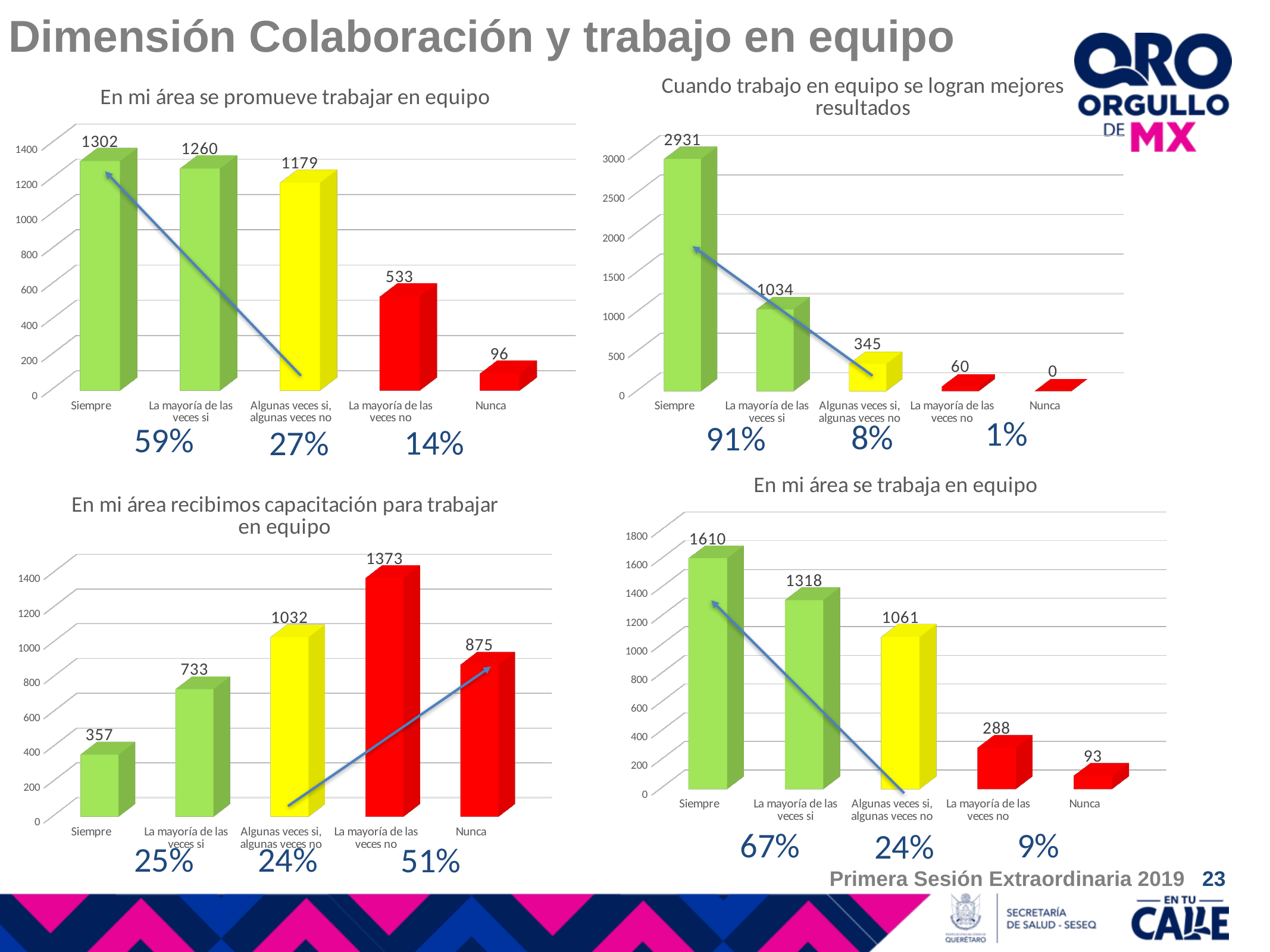
In the chart 'En mi área se trabaja en equipo', what is the value for 'La mayoría de las veces no'? 288 In the chart 'Cuando trabajo en equipo se logran mejores resultados', what is the value for 'Nunca'? 0 In the chart 'En mi área recibimos capacitación para trabajar en equipo', what is the value for 'Siempre'? 357 In the chart 'En mi área recibimos capacitación para trabajar en equipo', which is larger: 'Algunas veces si, algunas veces no' or 'Nunca'? Algunas veces si, algunas veces no How many categories are shown in the chart 'En mi área se trabaja en equipo'? 5 In the chart 'En mi área se trabaja en equipo', what is the difference between 'Siempre' and 'La mayoría de las veces si'? 292 In the chart 'En mi área se promueve trabajar en equipo', what is the value for 'Siempre'? 1302 In the chart 'Cuando trabajo en equipo se logran mejores resultados', what is the value for 'La mayoría de las veces si'? 1034 What kind of chart is 'En mi área se promueve trabajar en equipo'? Bar chart In the chart 'En mi área se promueve trabajar en equipo', which category has the lowest value? Nunca In the chart 'En mi área recibimos capacitación para trabajar en equipo', which category has the highest value? La mayoría de las veces no In the chart 'Cuando trabajo en equipo se logran mejores resultados', what is the difference between 'Siempre' and 'La mayoría de las veces si'? 1897